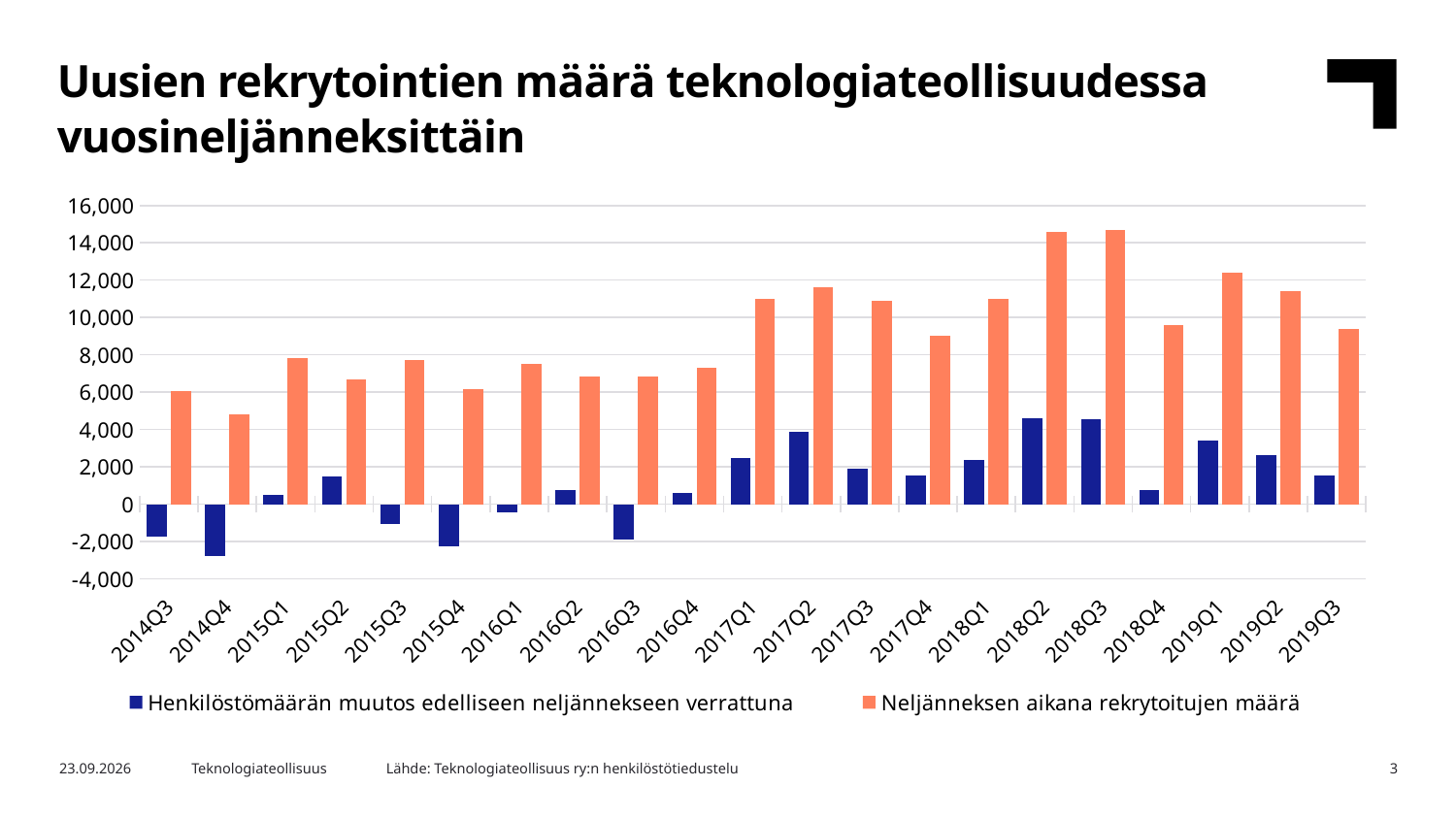
How many quarters are shown on the x axis of the chart? 21 How many series does the legend list? 2 Which is larger for 'Neljänneksen aikana rekrytoitujen määrä': 2019Q1 or 2019Q3? 2019Q1 What colour are the bars for 'Neljänneksen aikana rekrytoitujen määrä'? Orange Do the values for 'Neljänneksen aikana rekrytoitujen määrä' rise or fall from 2019Q1 to 2019Q3? fall Which quarter has the lowest value for 'Henkilöstömäärän muutos edelliseen neljännekseen verrattuna'? 2014Q4 Is the value for 'Neljänneksen aikana rekrytoitujen määrä' in 2017Q2 greater or less than 10,000? greater Is the value for 'Neljänneksen aikana rekrytoitujen määrä' in 2017Q4 greater or less than 10,000? less Is the value for 'Henkilöstömäärän muutos edelliseen neljännekseen verrattuna' in 2016Q3 greater or less than 0? less Which quarter has the lowest value for 'Neljänneksen aikana rekrytoitujen määrä'? 2014Q4 What kind of chart is shown on the slide? Bar chart